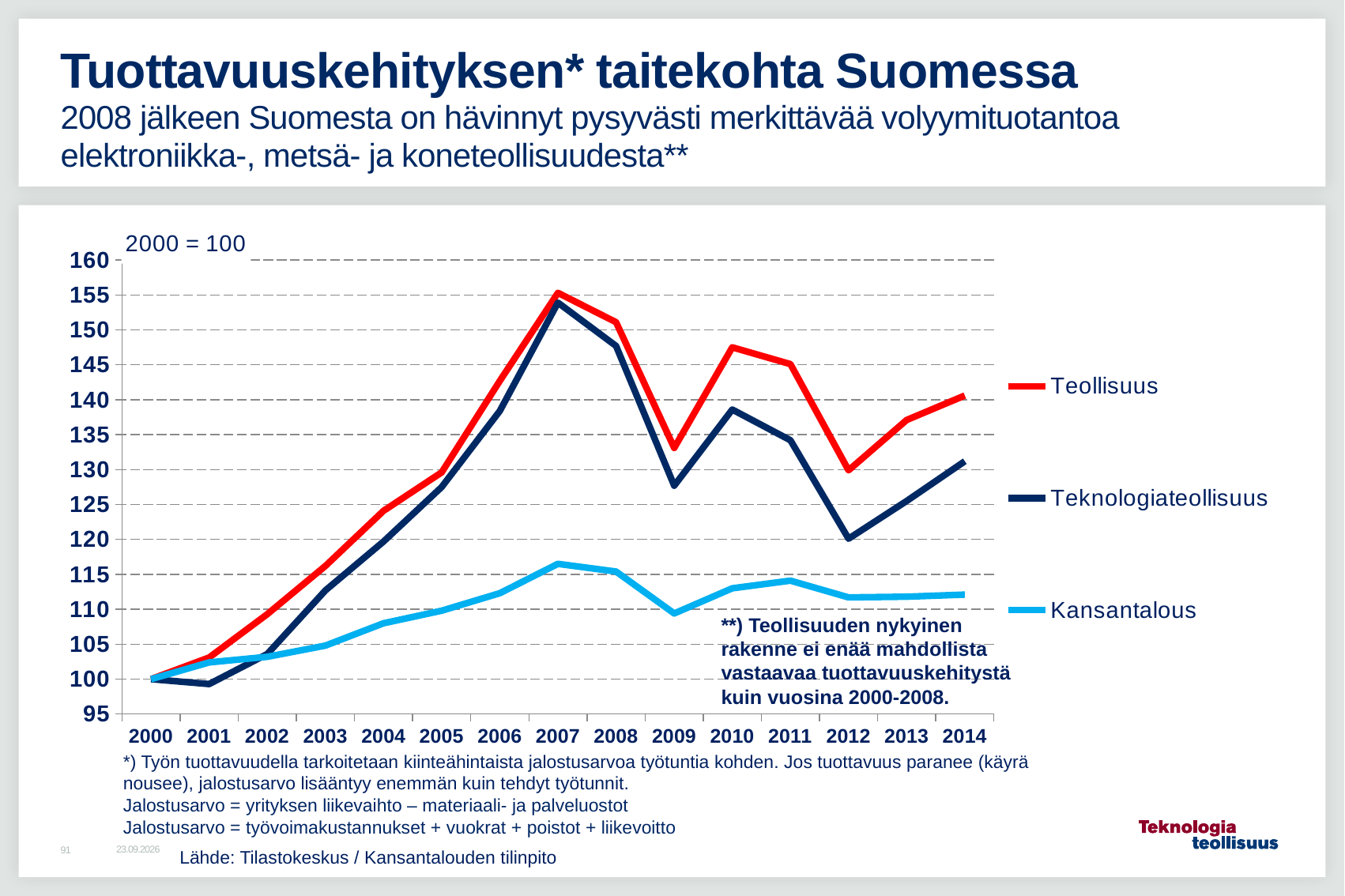
What is the value of all three series in 2000? 100 Does the Teknologiateollisuus series rise or fall from 2007 to 2009? fall In 2012, which is larger: Teollisuus or Teknologiateollisuus? Teollisuus How many series does the legend list? 3 Is the value for Teollisuus in 2007 greater or less than 150? greater Is the value for Teknologiateollisuus in 2009 greater or less than 130? less In which year does the Teollisuus series reach its highest value? 2007 What kind of chart is shown on the slide? line chart Is the value for Kansantalous in 2007 greater or less than 115? greater How many years are plotted along the x axis? 15 Which series has the lowest value in 2014? Kansantalous